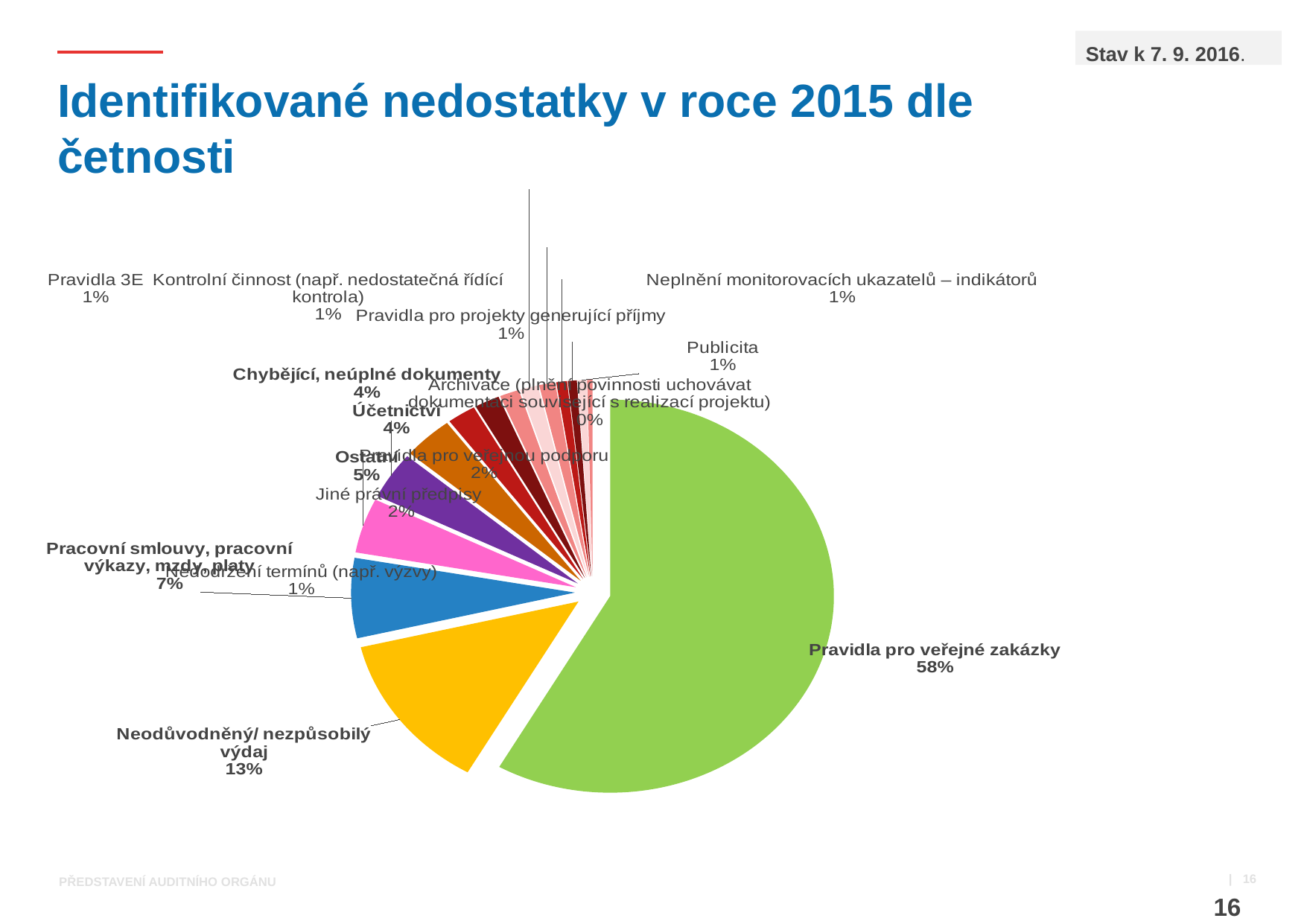
Which is larger, the share for Neodůvodněný/ nezpůsobilý výdaj or the share for Pracovní smlouvy, pracovní výkazy, mzdy, platy? Neodůvodněný/ nezpůsobilý výdaj What kind of chart is shown on the slide? pie chart What is the value shown for Pracovní smlouvy, pracovní výkazy, mzdy, platy? 7% What share of the pie does Neodůvodněný/ nezpůsobilý výdaj have? 13% What is the value shown for Jiné právní předpisy? 2% What is the value shown for Účetnictví? 4% What share of the pie does Pravidla pro veřejné zakázky have? 58% What is the value shown for Publicita? 1% What is the difference in percentage points between Pravidla pro veřejné zakázky and Neodůvodněný/ nezpůsobilý výdaj? 45 percentage points Which category has the largest share of the pie? Pravidla pro veřejné zakázky What is the title of the slide containing the chart? Identifikované nedostatky v roce 2015 dle četnosti What is the value shown for Ostatní? 5%